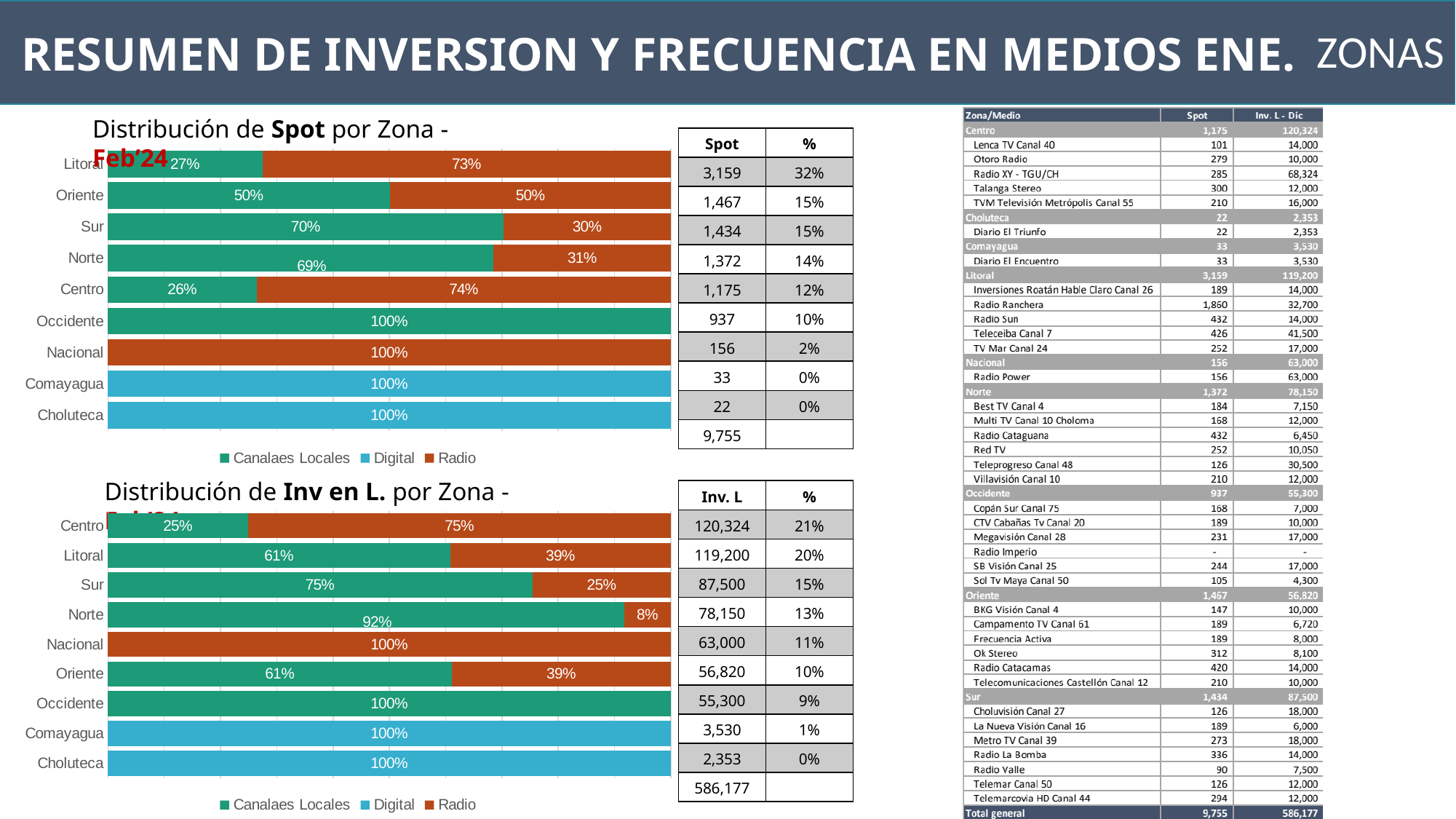
In the 'Distribución de Spot por Zona' chart, what percentage of Litoral is Radio? 73% In the 'Distribución de Inv en L. por Zona' chart, what percentage of Centro is Canalaes Locales? 25% How many zones are shown in the 'Distribución de Spot por Zona' chart? 9 How many series does the legend of the 'Distribución de Inv en L. por Zona' chart list? 3 What kind of chart is the 'Distribución de Inv en L. por Zona' chart? Stacked bar chart In the 'Distribución de Spot por Zona' chart, which zone has the highest Radio share? Nacional In the 'Distribución de Inv en L. por Zona' chart, what percentage of Litoral is Radio? 39% In the 'Distribución de Inv en L. por Zona' chart, what percentage of Norte is Radio? 8% In the 'Distribución de Spot por Zona' chart, what percentage of Sur is Canalaes Locales? 70% In the 'Distribución de Inv en L. por Zona' chart, what is the difference between the Canalaes Locales and Radio shares for Sur? 50% In the 'Distribución de Spot por Zona' chart, which has the larger Canalaes Locales share, Sur or Centro? Sur In the 'Distribución de Spot por Zona' chart, what percentage of Oriente is Radio? 50%